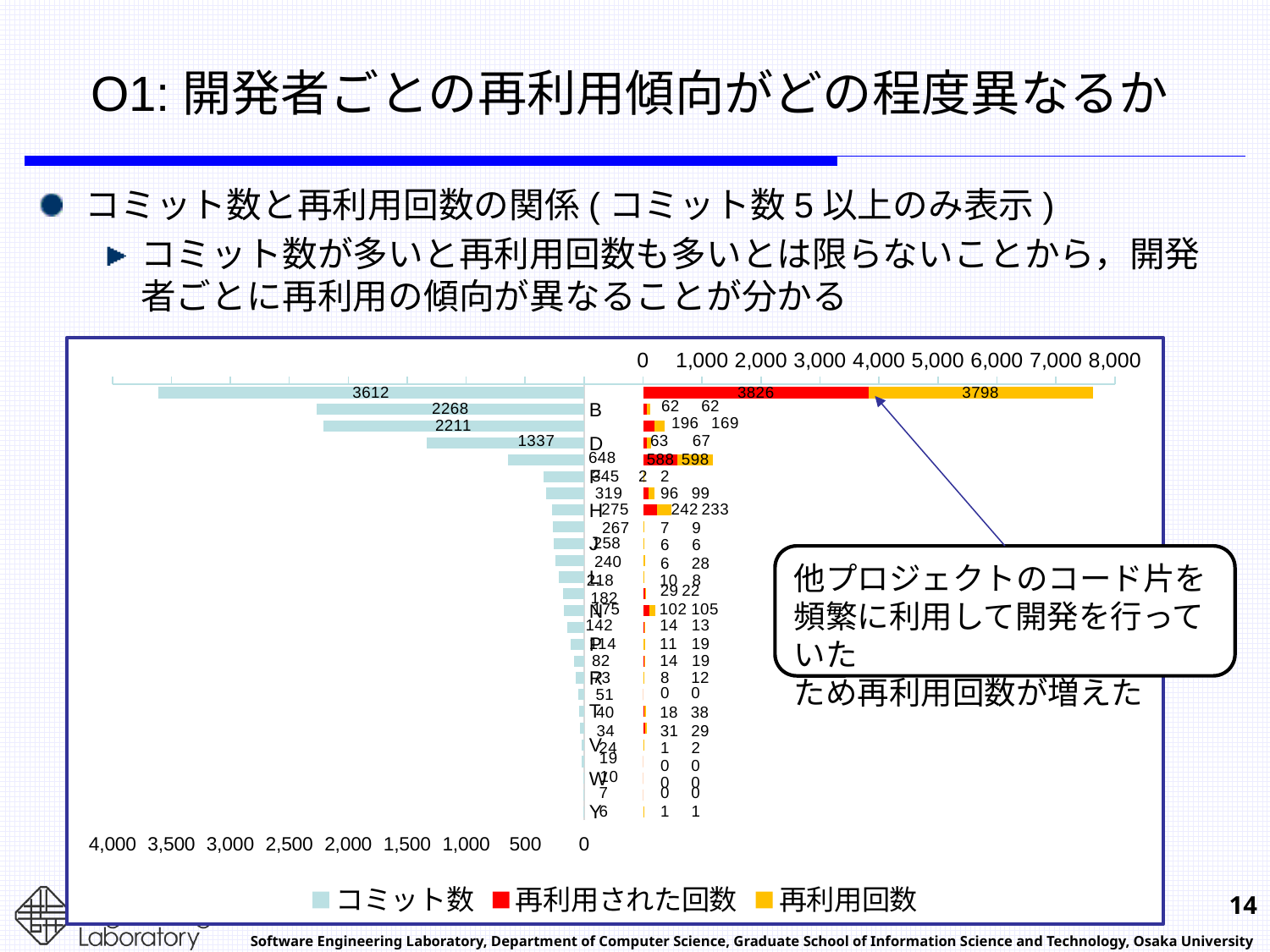
What kind of chart is shown on the slide? bar chart What is the 再利用回数 value for developer D? 67 Is the コミット数 value for developer B greater or less than 2,000? greater Which developer has the larger 再利用回数 value, N or T? N How many series does the chart legend list? 3 What is the difference between the コミット数 values for developers B and D? 931 What is the 再利用回数 value for developer T? 38 What are the three legend entries of the chart? コミット数, 再利用された回数, 再利用回数 What is the コミット数 value for developer B? 2268 What is the largest 再利用回数 value shown in the chart? 3798 What is the largest コミット数 value shown in the chart? 3612 What is the 再利用された回数 value for developer H? 242